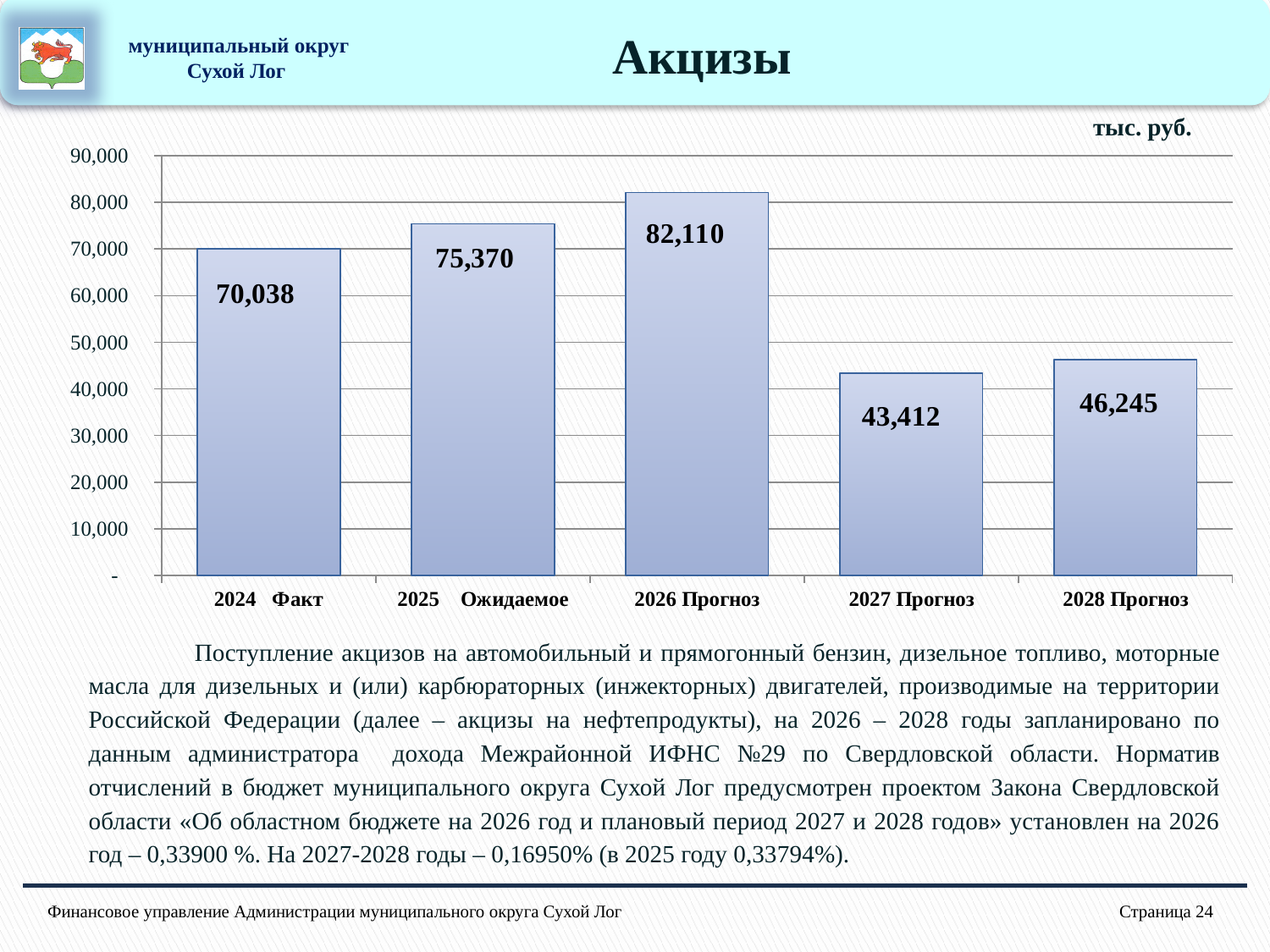
Which category has the lowest value? 2027 Прогноз Which is larger, the value for 2025 Ожидаемое or the value for 2024 Факт? 2025 Ожидаемое Is the value for 2026 Прогноз greater or less than 80,000? greater What is the difference between the values for 2028 Прогноз and 2027 Прогноз? 2,833 What kind of chart is shown on the slide? bar chart What is the value for 2028 Прогноз? 46,245 Which category has the highest value? 2026 Прогноз What unit is indicated above the chart? тыс. руб. What is the value for 2027 Прогноз? 43,412 What is the value for 2024 Факт? 70,038 How many categories are shown on the x axis? 5 What is the difference between the values for 2026 Прогноз and 2025 Ожидаемое? 6,740